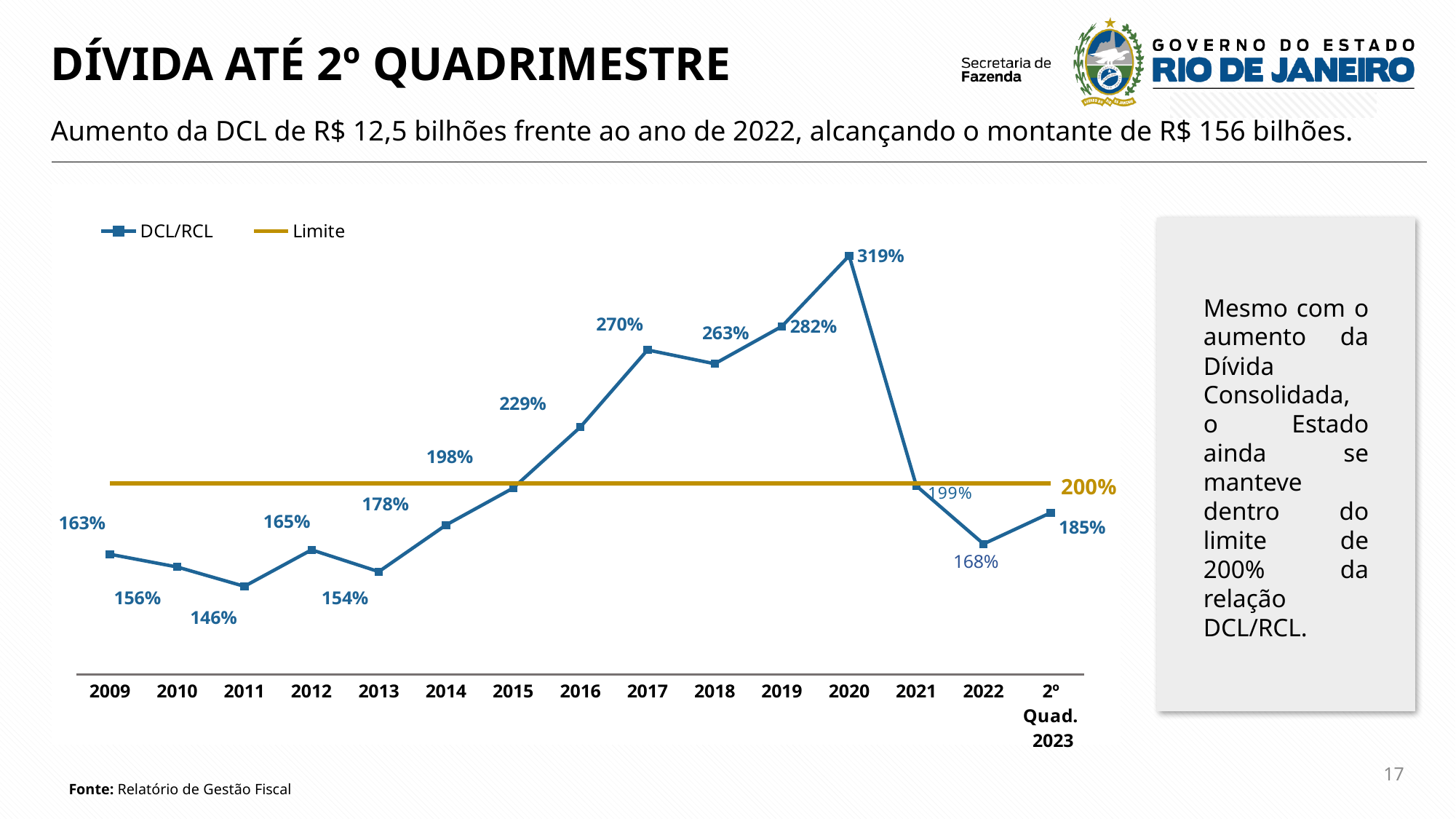
How many series does the legend list? 2 What is the DCL/RCL value for 2017? 270% Which year has the lowest DCL/RCL value? 2011 What is the DCL/RCL value for 2011? 146% Which year has the highest DCL/RCL value? 2020 What is the DCL/RCL value for 2020? 319% What is the DCL/RCL value for 2º Quad. 2023? 185% How many data points does the DCL/RCL line have? 15 What kind of chart is shown on the slide? Line chart Which is larger, the DCL/RCL value for 2017 or for 2018? 2017 What value does the Limite line mark? 200% What is the difference between the DCL/RCL values for 2020 and 2021? 120%